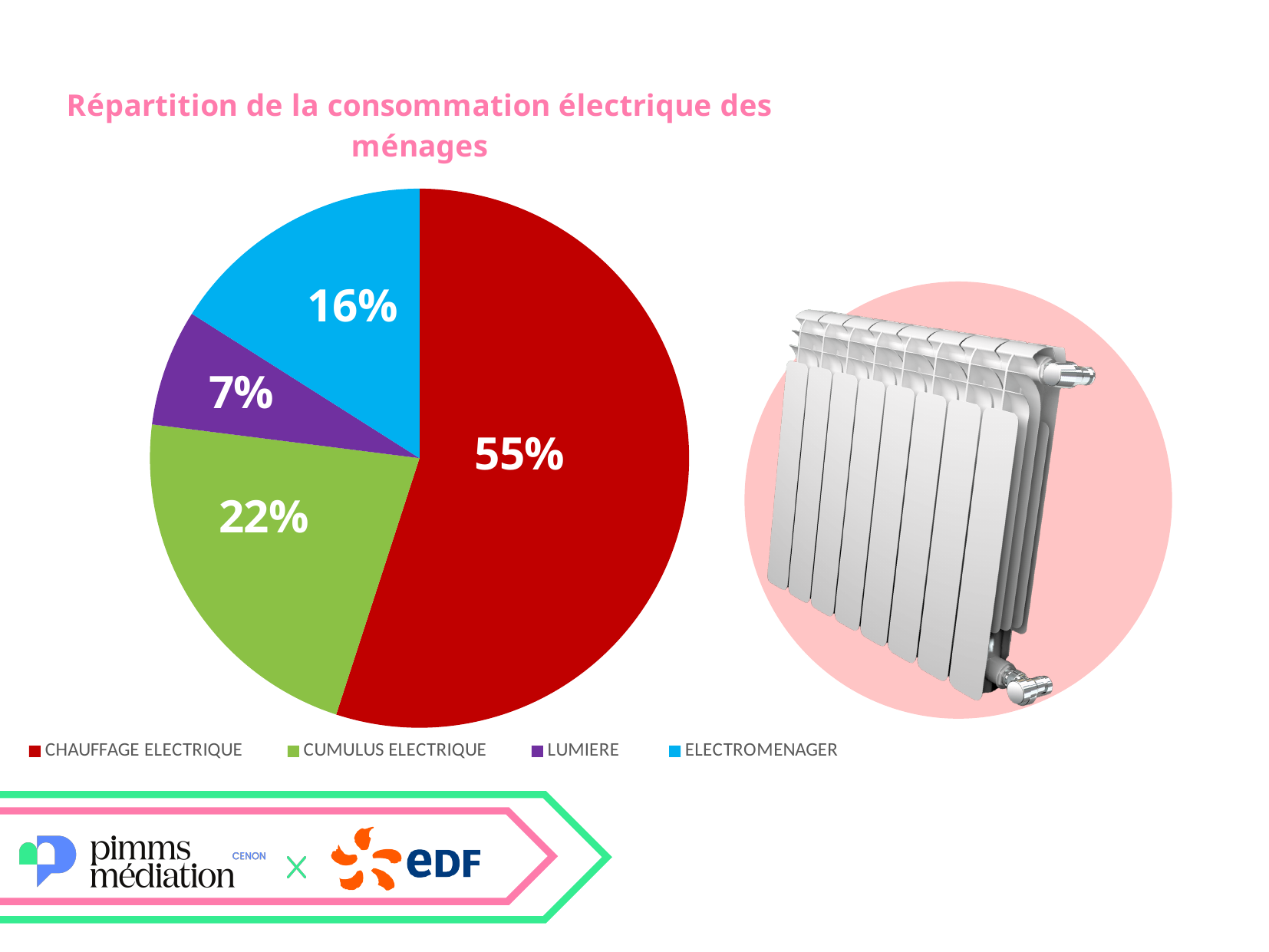
What percentage is shown for CUMULUS ELECTRIQUE? 22% Which category has the largest share of the pie? CHAUFFAGE ELECTRIQUE What is the title of the chart? Répartition de la consommation électrique des ménages What kind of chart is shown on the slide? Pie chart What percentage is shown for LUMIERE? 7% Which is larger, the share for ELECTROMENAGER or the share for LUMIERE? ELECTROMENAGER What colour is the slice for CUMULUS ELECTRIQUE? Green How many categories does the pie chart show? 4 Which category has the smallest share of the pie? LUMIERE What percentage is shown for ELECTROMENAGER? 16% What is the difference in percentage points between CHAUFFAGE ELECTRIQUE and CUMULUS ELECTRIQUE? 33 What share of household electricity consumption does CHAUFFAGE ELECTRIQUE account for? 55%